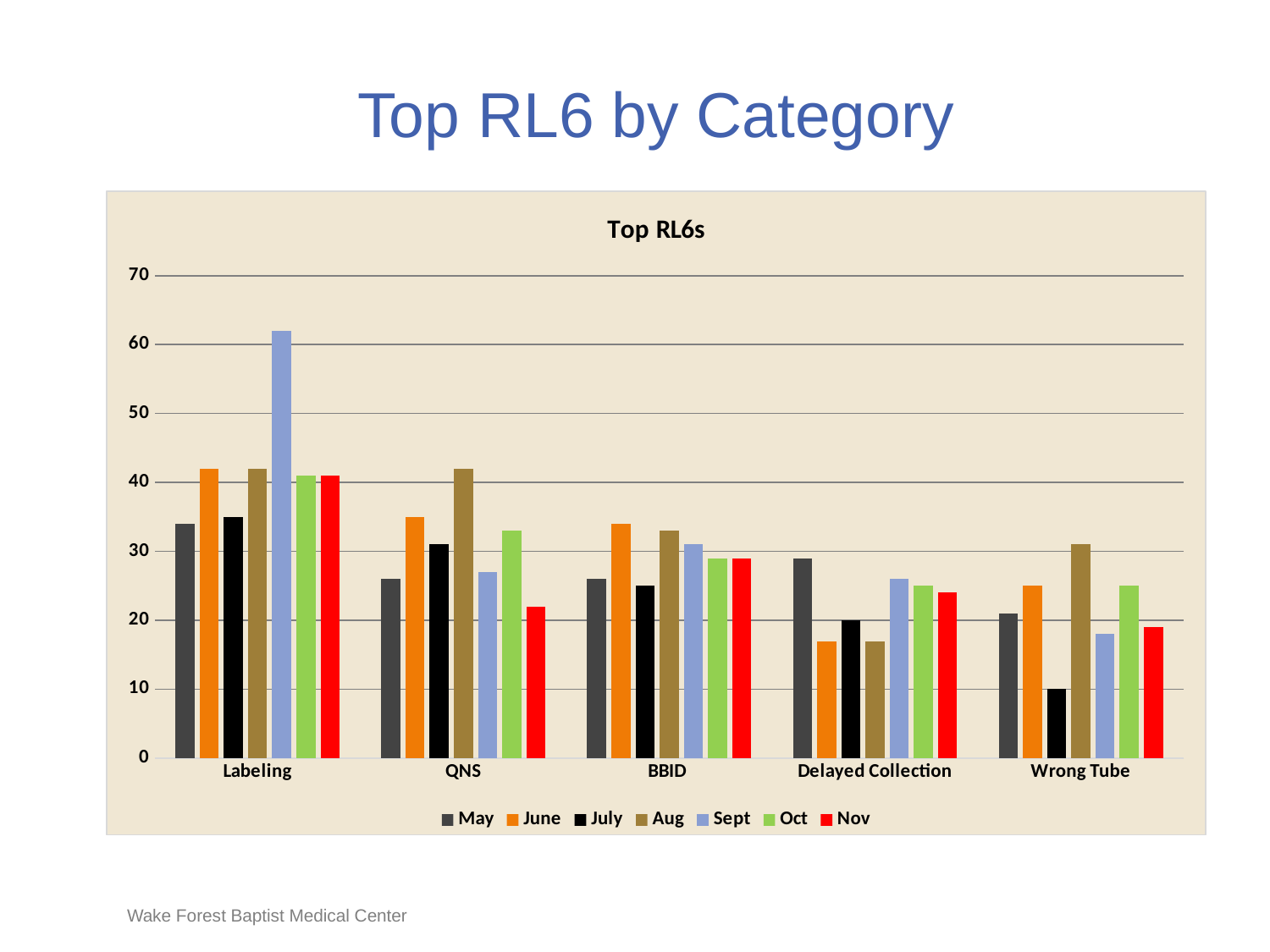
Is the Nov value for QNS greater or less than 30? less For Delayed Collection, which is larger: the May value or the June value? May How many categories are shown along the x axis of the chart? 5 What kind of chart is shown on the slide? bar chart Is the Aug value for Wrong Tube greater or less than 20? greater Within the Wrong Tube category, which month has the lowest value? July How many series does the chart's legend list? 7 For Labeling, which is larger: the May value or the June value? June Is the Sept value for Labeling greater or less than 60? greater Which category and month has the tallest bar in the chart? Labeling, Sept What is the title shown inside the chart area? Top RL6s